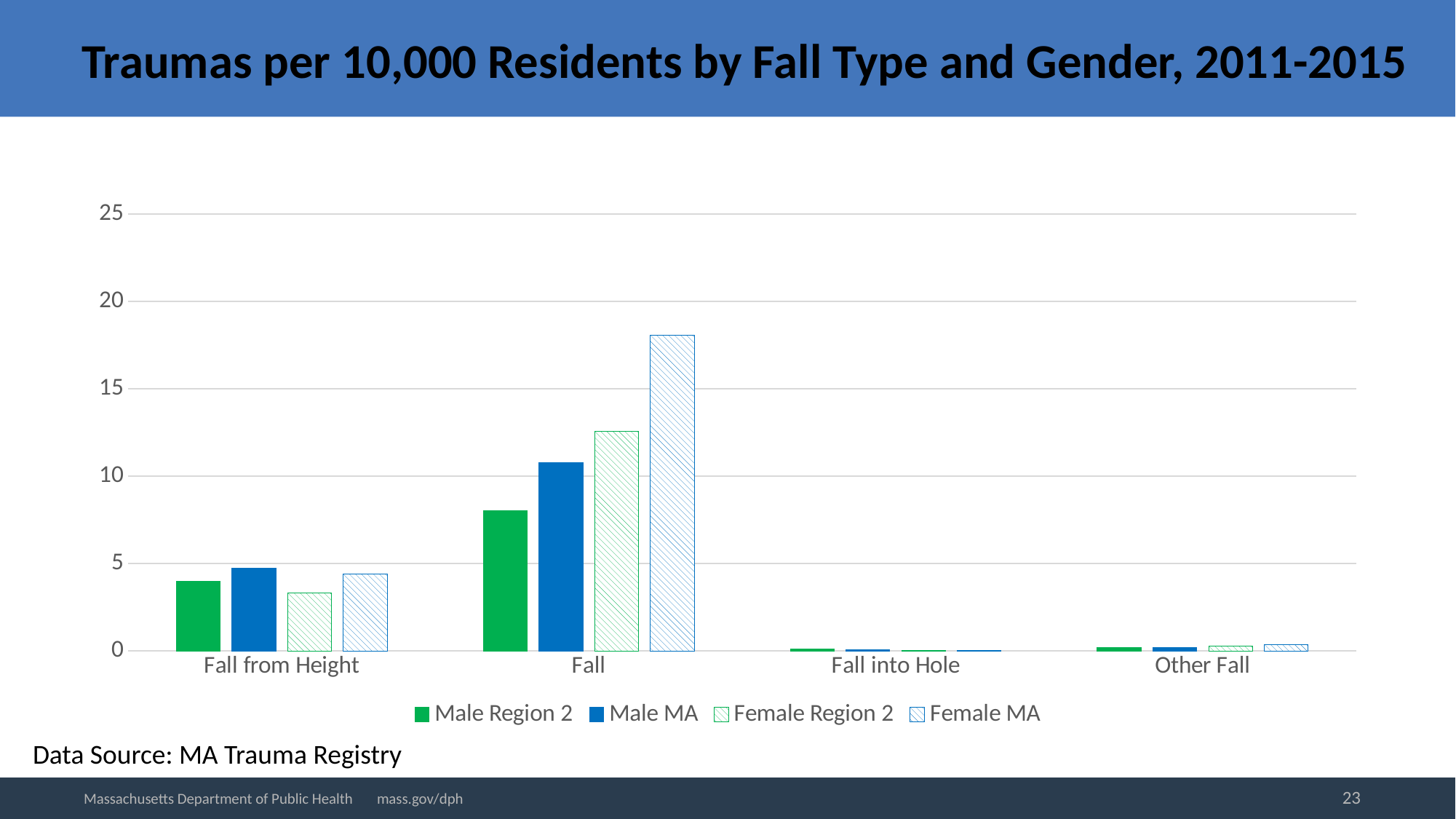
Which fall type has the highest Female MA value? Fall How many series does the legend list? 4 For Fall from Height, which is larger: the Male MA value or the Female Region 2 value? Male MA What is the title of the chart? Traumas per 10,000 Residents by Fall Type and Gender, 2011-2015 Is the Female MA value for Fall greater or less than 15? greater How many fall type categories are shown on the x axis? 4 What kind of chart is shown on the slide? bar chart For Fall, which is larger: the Female MA value or the Male MA value? Female MA Which fall type has the lowest Male Region 2 value? Fall into Hole Is the Female Region 2 value for Fall from Height greater or less than 5? less Is the Male Region 2 value for Fall greater or less than 10? less